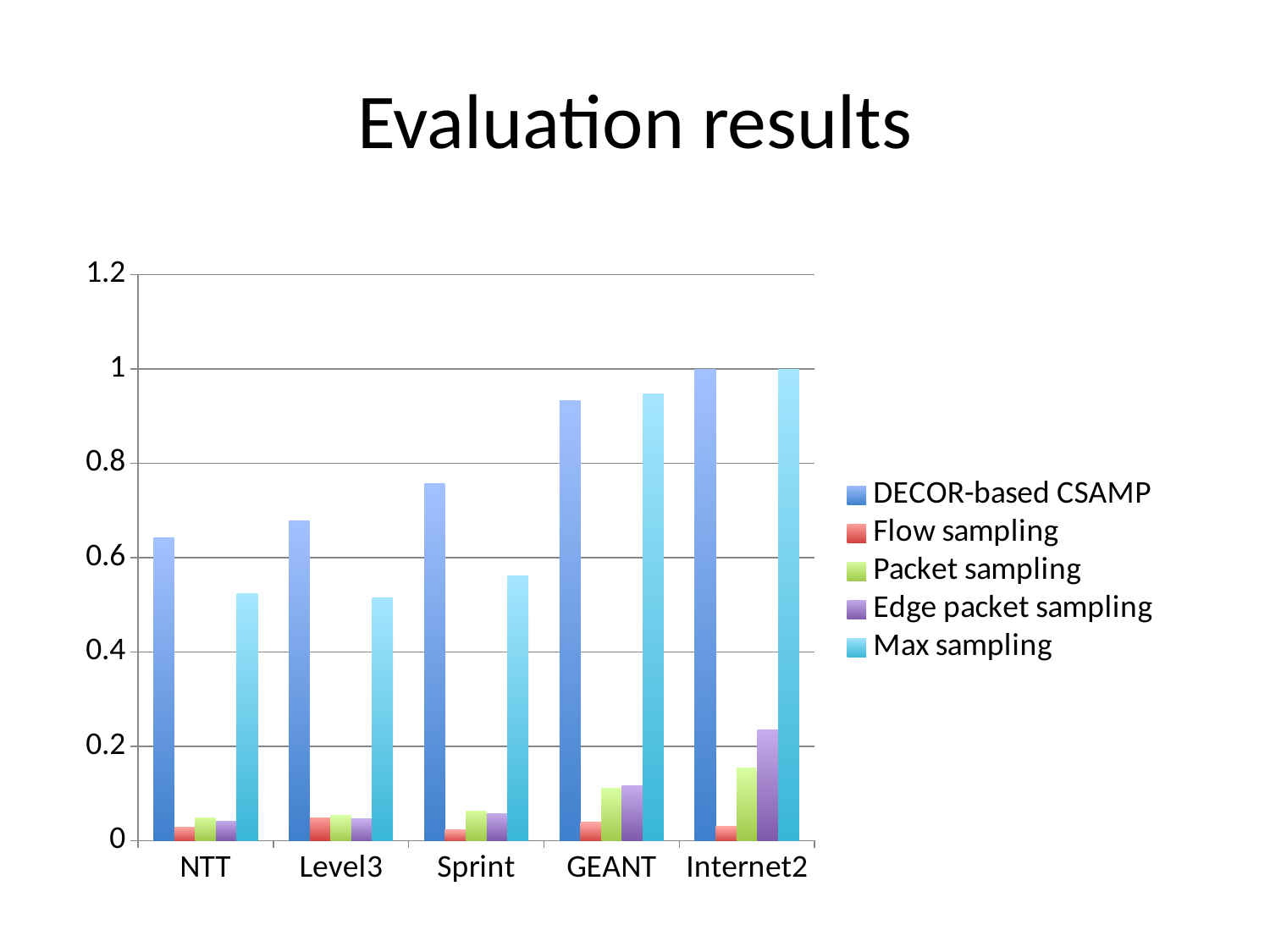
Which is larger for Internet2: Packet sampling or Edge packet sampling? Edge packet sampling What is the title of the slide? Evaluation results Is the Max sampling value for NTT greater or less than 0.4? greater How many categories are shown on the x axis? 5 Is the DECOR-based CSAMP value for Level3 greater or less than 0.8? less What kind of chart is shown on the slide? bar chart Which is larger for NTT: DECOR-based CSAMP or Max sampling? DECOR-based CSAMP Is the Packet sampling value for Internet2 greater or less than 0.2? less How many series does the legend list? 5 For which category is the DECOR-based CSAMP value highest? Internet2 Do the DECOR-based CSAMP values rise or fall from NTT to Internet2 along the x axis? rise